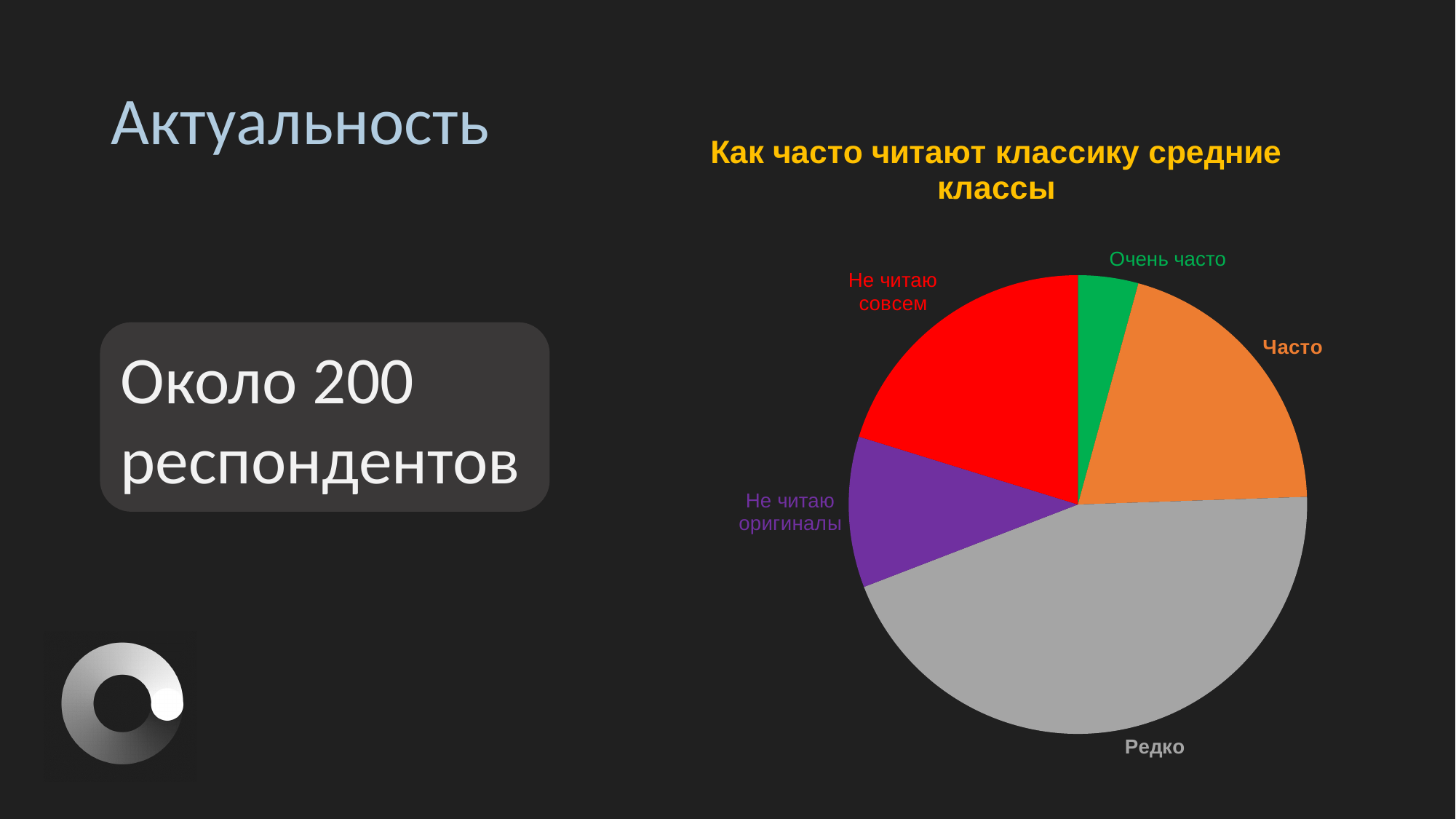
What kind of chart is shown on the slide? Pie chart What is the title of the pie chart? Как часто читают классику средние классы Which category has the largest slice of the pie chart? Редко What colour is the Редко slice in the pie chart? Grey Which category has the smallest slice of the pie chart? Очень часто How many categories (slices) does the pie chart have? 5 Which slice is larger: Не читаю оригиналы or Очень часто? Не читаю оригиналы Which slice is larger: Часто or Очень часто? Часто Which slice is larger: Редко or Не читаю совсем? Редко